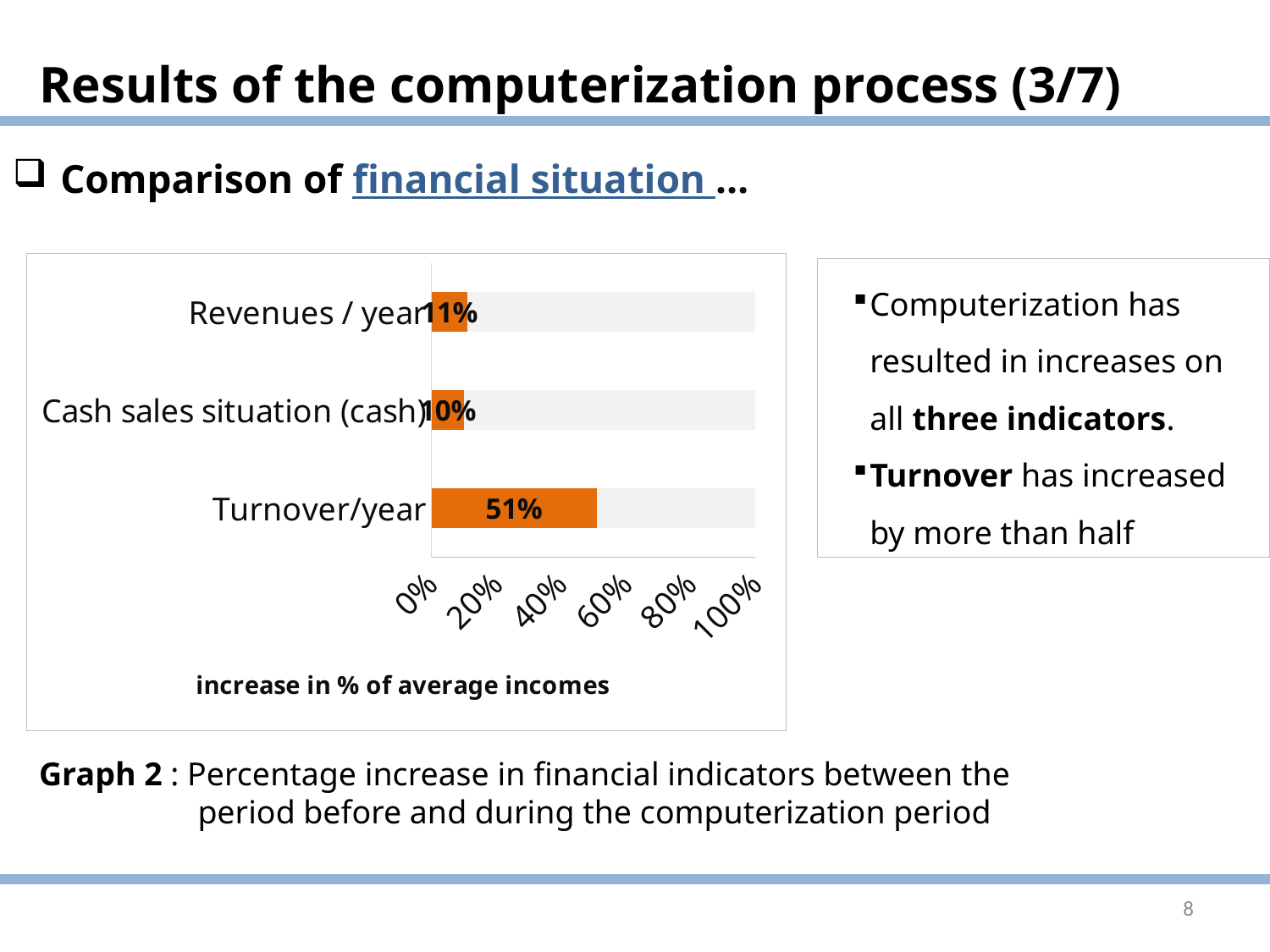
Which category has the highest value? Turnover/year What kind of chart is shown on the slide? bar chart What is the axis label shown below the chart? increase in % of average incomes What is the value for Revenues / year? 11% Is the value for Revenues / year greater or less than 20%? less What is the value for Cash sales situation (cash)? 10% Which is larger, the value for Turnover/year or the value for Cash sales situation (cash)? Turnover/year Is the value for Turnover/year greater or less than 40%? greater What is the value for Turnover/year? 51% Which category has the lowest value? Cash sales situation (cash) What is the difference between the values for Turnover/year and Revenues / year? 40% How many categories are shown in the chart? 3